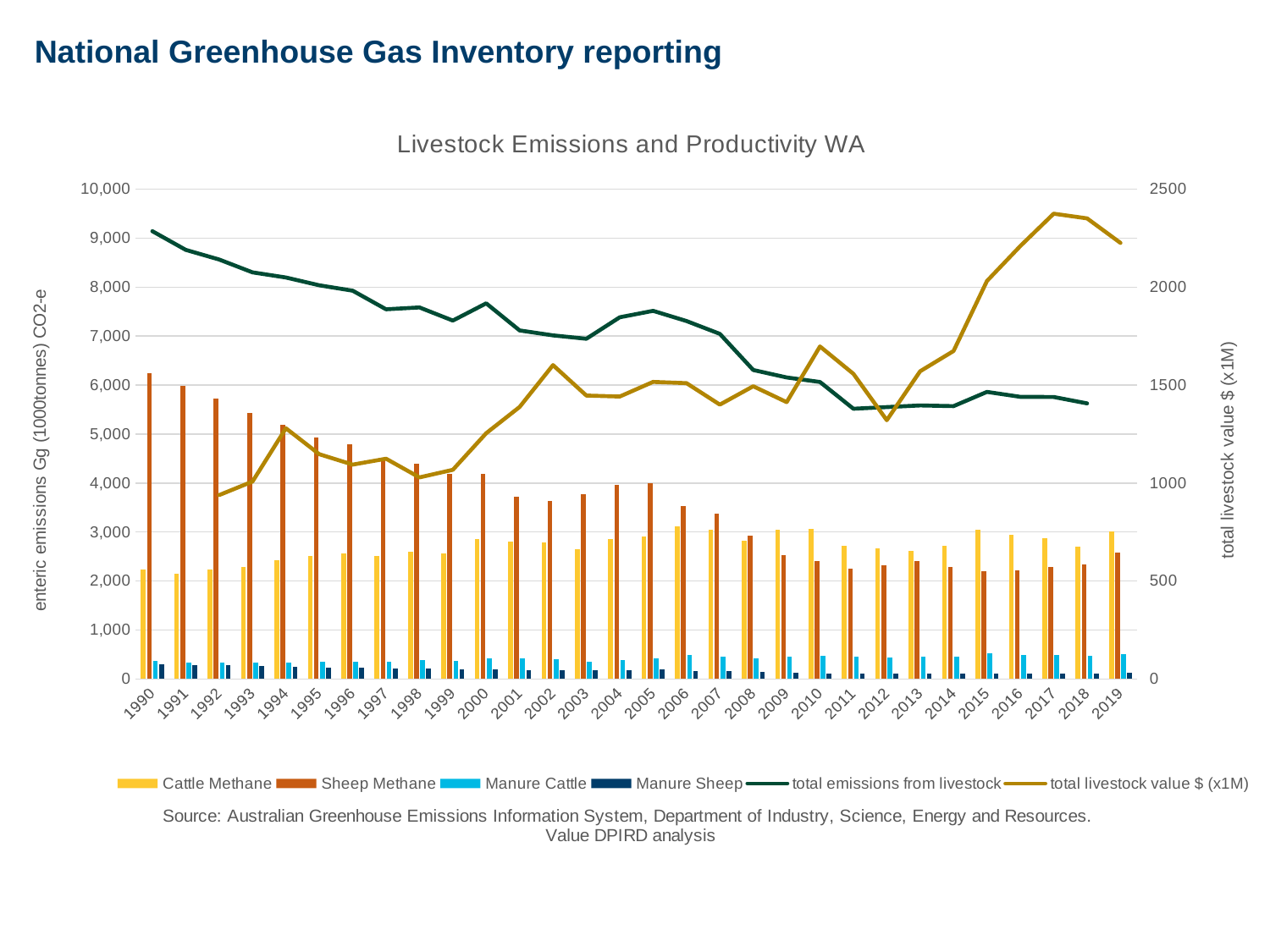
In which year is Sheep Methane highest? 1990 How many years are shown on the x axis of the chart? 30 How many series does the chart legend list? 6 Is the value for Sheep Methane in 1990 greater or less than 5,000? greater What kind of chart is this? Combined bar and line chart Is the value for Cattle Methane in 1990 greater or less than 3,000? less In which year is total emissions from livestock highest? 1990 Is the value for total livestock value $ (x1M) in 2017 greater or less than 2000? greater In 2019, which is larger: Cattle Methane or Sheep Methane? Cattle Methane In which year is total livestock value $ (x1M) lowest? 1992 Does total emissions from livestock generally rise or fall from 1990 to 2019? fall What is the title of the chart? Livestock Emissions and Productivity WA